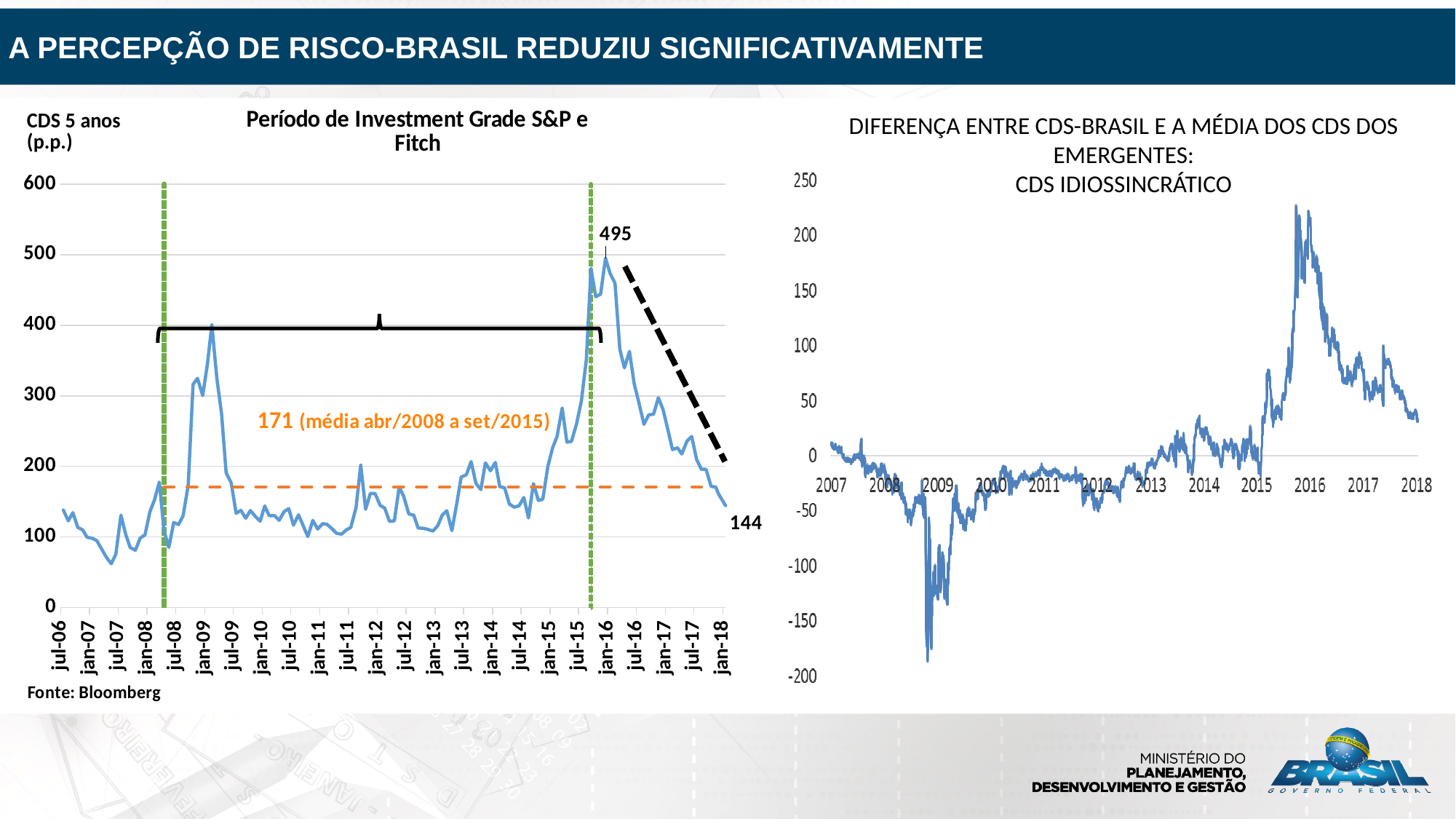
In the left chart (CDS 5 anos), what value is labelled at the end of the series at jan-18? 144 In the right chart (CDS idiossincrático), do the values rise or fall from 2016 to 2018? fall In the left chart (CDS 5 anos), what is the peak value labelled near jan-16? 495 In the left chart (CDS 5 anos), is the value around jan-09 greater or less than 300? greater What kind of chart is the right chart titled 'Diferença entre CDS-Brasil e a média dos CDS dos emergentes'? line chart In the right chart (CDS idiossincrático), is the lowest value around 2009 greater or less than -150? less What kind of chart is the left chart titled 'Período de Investment Grade S&P e Fitch'? line chart In the right chart (CDS idiossincrático), is the peak value around 2016 greater or less than 200? greater In the left chart (CDS 5 anos), what is the average value shown for abr/2008 a set/2015? 171 In the left chart (CDS 5 anos), what is the difference between the labelled peak of 495 and the final value of 144? 351 In the left chart (CDS 5 anos), which is larger: the labelled value near jan-16 or the labelled value at jan-18? jan-16 (495)